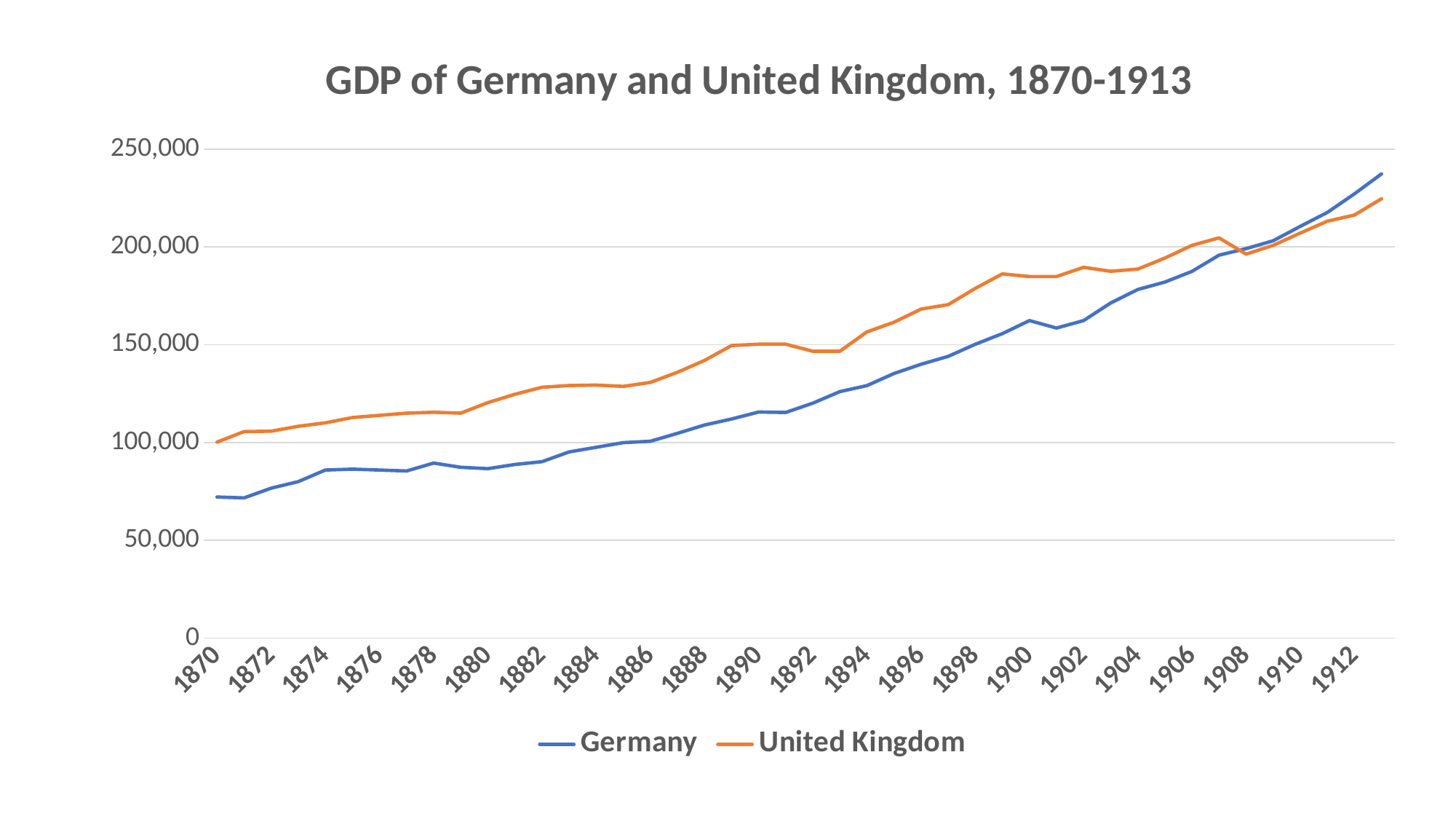
In 1890, which has the larger GDP, Germany or the United Kingdom? United Kingdom Which colour is used for the United Kingdom line? orange Does the GDP of the United Kingdom rise or fall overall from 1870 to 1912? rise Is the value for the United Kingdom in 1900 greater or less than 200,000? less What kind of chart is shown on the slide? line chart Is the value for Germany in 1870 greater or less than 100,000? less How many series does the legend list? 2 Does the GDP of Germany rise or fall overall from 1870 to 1912? rise Is the value for the United Kingdom in 1880 greater or less than 100,000? greater In 1912, which has the larger GDP, Germany or the United Kingdom? Germany What is the title of the chart? GDP of Germany and United Kingdom, 1870-1913